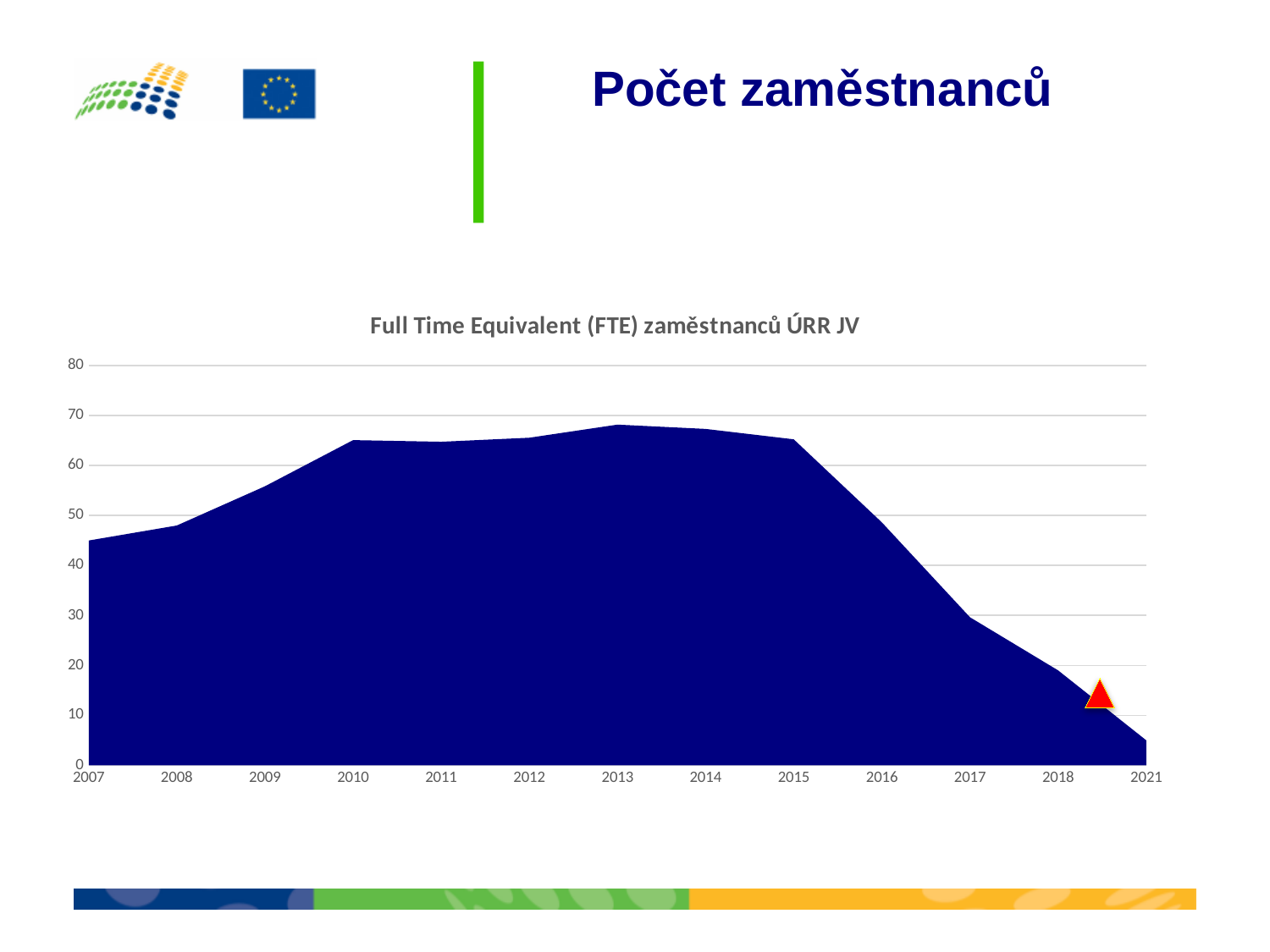
Do the values rise or fall from 2015 to 2021? fall Is the value for 2013 greater or less than 60? greater Is the value for 2010 greater or less than 60? greater Which is larger, the value for 2010 or the value for 2017? 2010 Is the value for 2007 greater or less than 50? less Which year has the lowest value in the chart? 2021 How many years are plotted along the x axis of the chart? 13 What is the title of the chart? Full Time Equivalent (FTE) zaměstnanců ÚRR JV What kind of chart is shown on the slide? area chart Do the values rise or fall from 2007 to 2010? rise